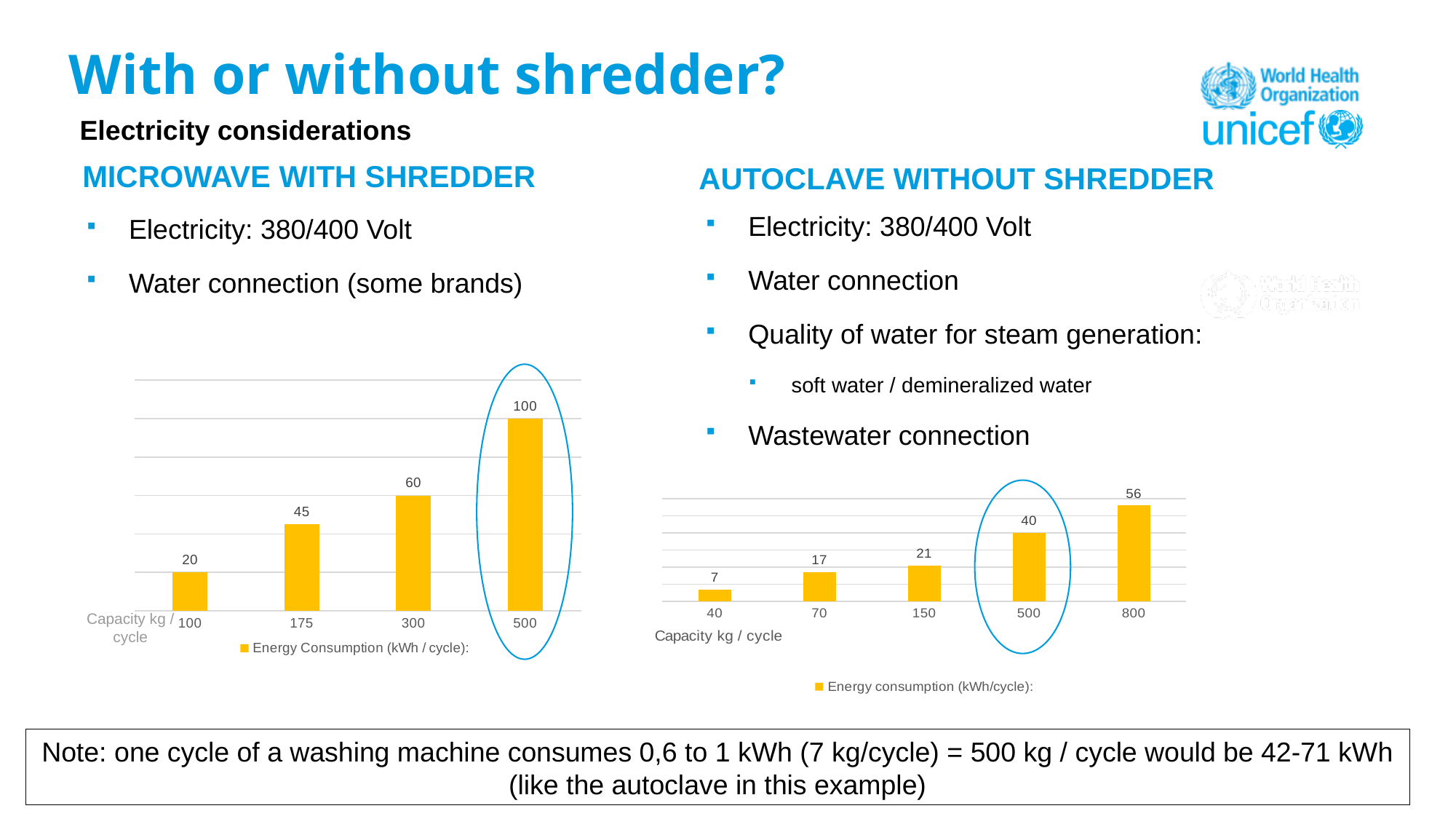
How many capacity categories are shown in the left chart (Microwave with shredder)? 4 In the left chart (Microwave with shredder), what is the energy consumption for a capacity of 500 kg/cycle? 100 In the right chart (Autoclave without shredder), what is the energy consumption for a capacity of 500 kg/cycle? 40 In the left chart (Microwave with shredder), what is the energy consumption for a capacity of 175 kg/cycle? 45 In the left chart (Microwave with shredder), what is the difference in energy consumption between the 500 and 300 kg/cycle capacities? 40 What type of chart is the left chart (Microwave with shredder)? Bar chart In the right chart (Autoclave without shredder), what is the difference in energy consumption between the 800 and 500 kg/cycle capacities? 16 In the right chart (Autoclave without shredder), which capacity has the highest energy consumption? 800 In the right chart (Autoclave without shredder), do the energy consumption values rise or fall as capacity increases? Rise How many capacity categories are shown in the right chart (Autoclave without shredder)? 5 In the right chart (Autoclave without shredder), which capacity has the lowest energy consumption? 40 Which is larger: the energy consumption at 500 kg/cycle in the left chart (Microwave with shredder) or in the right chart (Autoclave without shredder)? Microwave with shredder